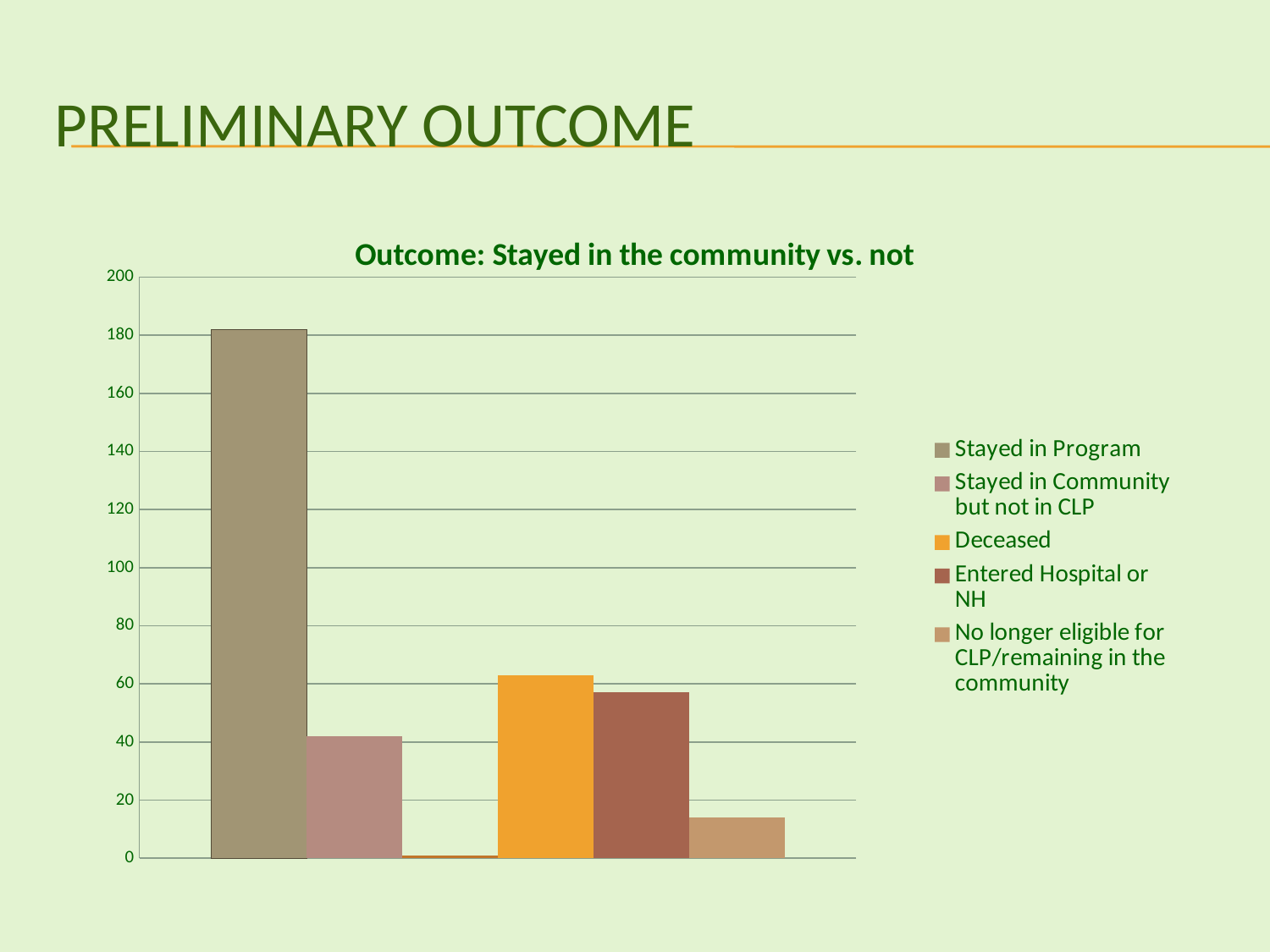
Is the value for No longer eligible for CLP/remaining in the community greater or less than 20? less Which is larger, the value for Deceased or the value for Stayed in Community but not in CLP? Deceased Which is larger, the value for Stayed in Community but not in CLP or the value for No longer eligible for CLP/remaining in the community? Stayed in Community but not in CLP What is the title of the chart? Outcome: Stayed in the community vs. not Is the value for Entered Hospital or NH greater or less than 40? greater Is the value for Stayed in Program greater or less than 160? greater How many series does the chart's legend list? 5 What colour is the bar for Deceased? orange What kind of chart is shown on the slide? bar chart Which series has the highest value in the chart? Stayed in Program